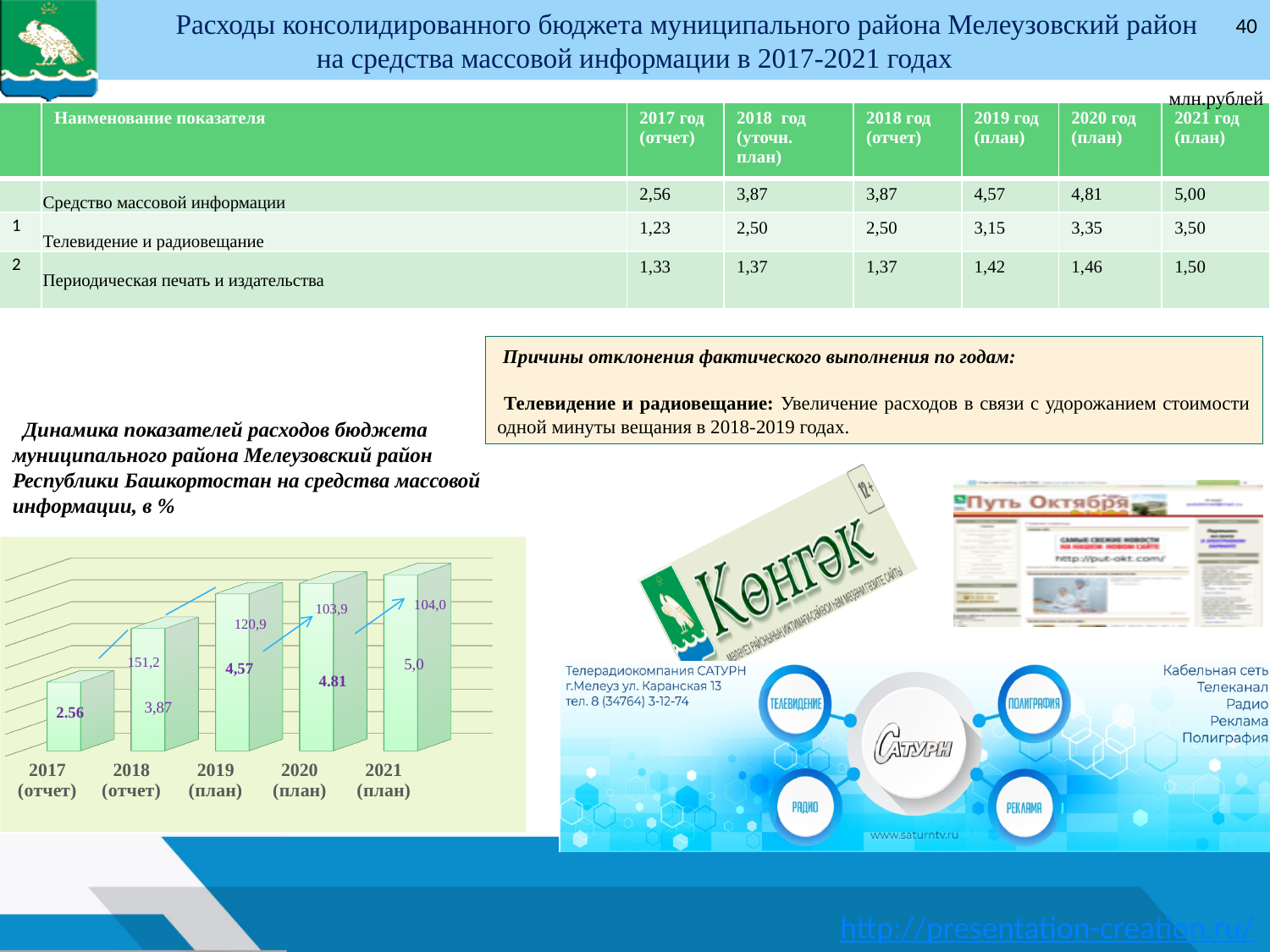
What is the difference between the values for 2020 (план) and 2019 (план) in the chart? 0,24 What kind of chart is shown on the slide? bar chart Which year has the highest bar in the chart? 2021 (план) What is the value shown for 2018 (отчет) in the chart? 3,87 Do the bar values rise or fall from 2017 to 2021 in the chart? rise Which is larger in the chart: the value for 2019 (план) or for 2018 (отчет)? 2019 (план) What is the value shown for 2019 (план) in the chart? 4,57 What is the value shown for 2021 (план) in the chart? 5,0 What percentage growth label is shown above the 2018 (отчет) bar in the chart? 151,2 What is the value shown for 2017 (отчет) in the chart? 2.56 How many bars (years) are plotted in the chart? 5 Which year has the lowest bar in the chart? 2017 (отчет)